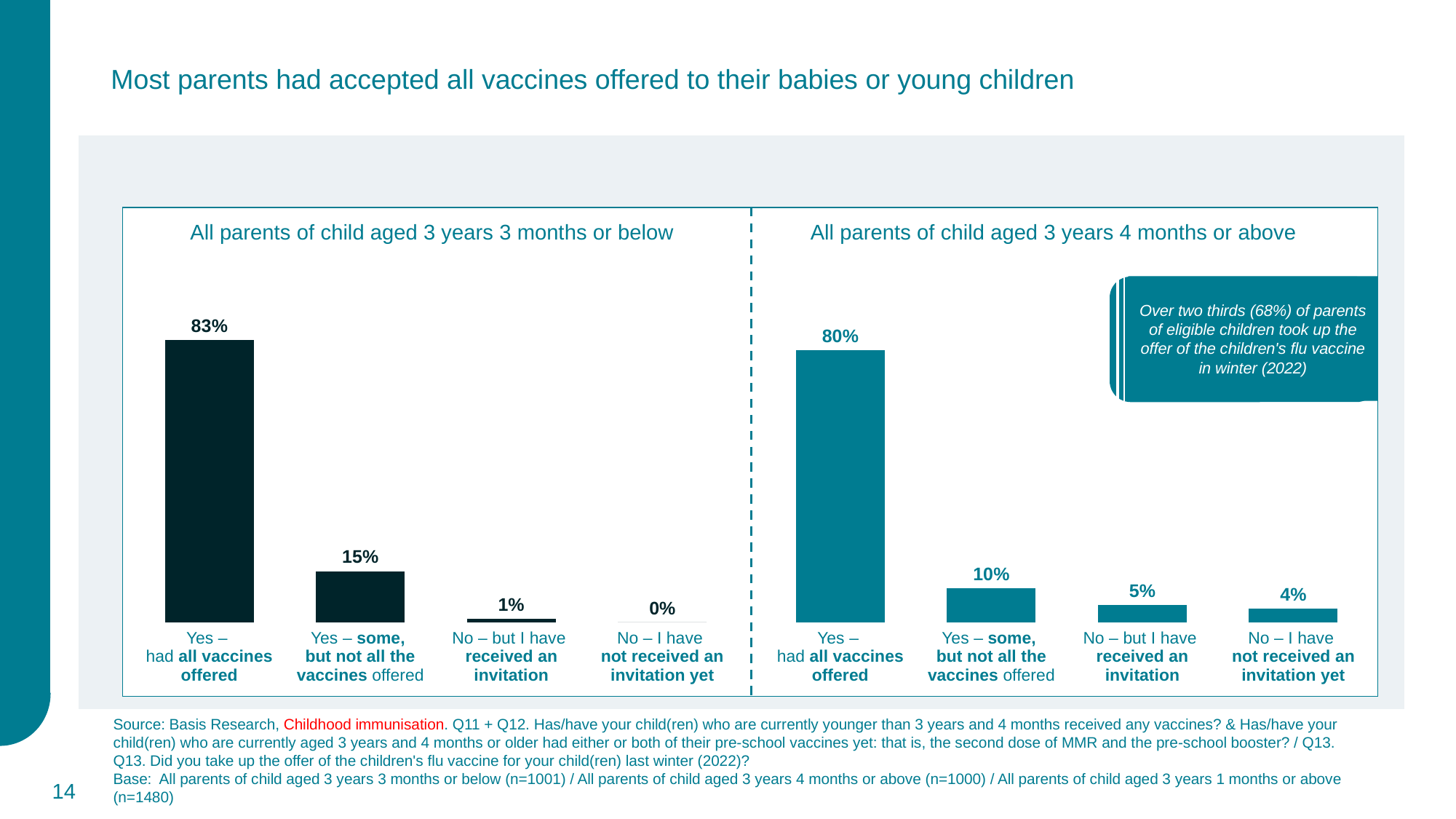
In the chart 'All parents of child aged 3 years 4 months or above', what percentage had all vaccines offered? 80% In the chart 'All parents of child aged 3 years 4 months or above', what is the difference between 'Yes – some, but not all the vaccines offered' and 'No – but I have received an invitation'? 5 percentage points Which is larger: 'No – but I have received an invitation' in the left chart (3 years 3 months or below) or in the right chart (3 years 4 months or above)? Right chart (3 years 4 months or above) What type of chart is used on this slide? Bar chart What is the difference between the 'Yes – had all vaccines offered' values in the left chart (3 years 3 months or below) and the right chart (3 years 4 months or above)? 3 percentage points In the chart 'All parents of child aged 3 years 4 months or above', which category has the highest value? Yes – had all vaccines offered In the chart 'All parents of child aged 3 years 3 months or below', what percentage said 'Yes – some, but not all the vaccines offered'? 15% In the chart 'All parents of child aged 3 years 4 months or above', what percentage said 'No – I have not received an invitation yet'? 4% In the chart 'All parents of child aged 3 years 3 months or below', what percentage had all vaccines offered? 83% According to the callout box on the right chart, what percentage of parents of eligible children took up the offer of the children's flu vaccine in winter 2022? 68% How many categories are shown in the chart 'All parents of child aged 3 years 3 months or below'? 4 In the chart 'All parents of child aged 3 years 3 months or below', which category has the lowest value? No – I have not received an invitation yet